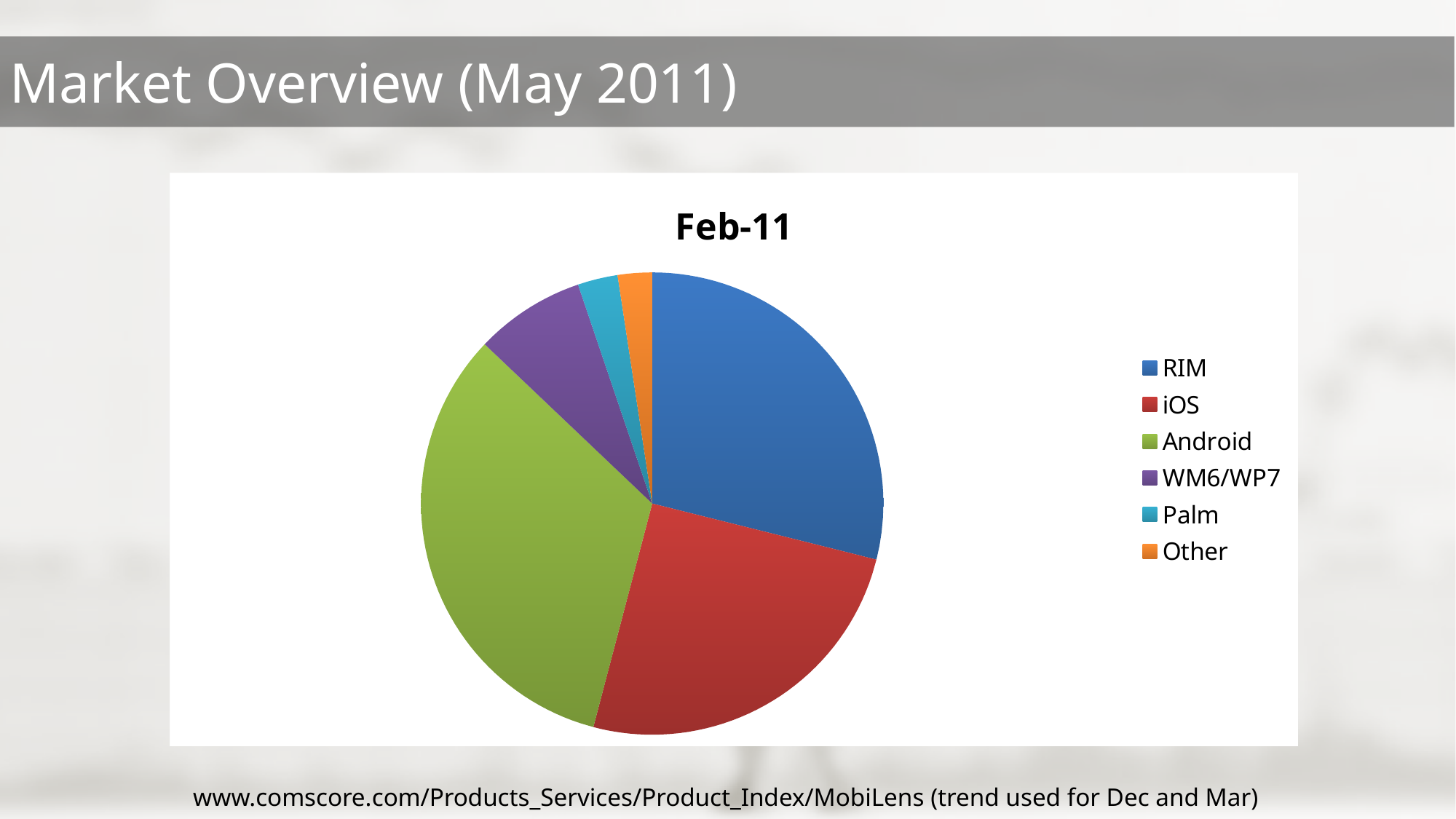
Which slice is larger, Android or Other? Android What kind of chart is shown on the slide? pie chart How many entries does the legend list? 6 How many slices does the pie chart have? 6 Which slice is larger, iOS or WM6/WP7? iOS Which slice is larger, RIM or WM6/WP7? RIM Which category is represented by the green slice? Android What is the title of the chart? Feb-11